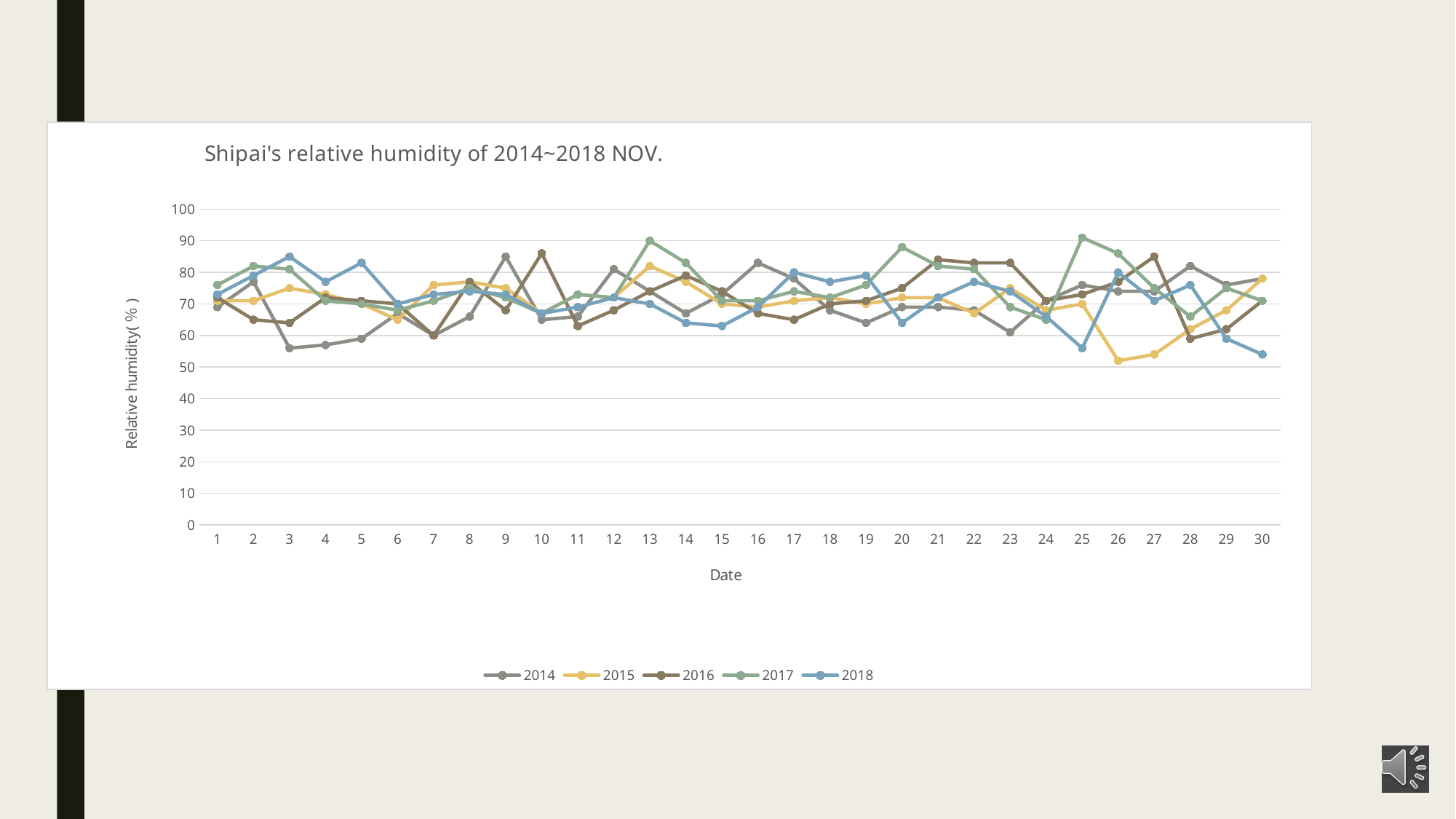
What is the label of the y axis? Relative humidity( % ) On date 26, which is larger, the value for 2015 or the value for 2017? 2017 How many series does the legend list? 5 Is the value for 2014 on date 3 greater or less than 60? less How many dates are plotted along the x axis? 30 Is the value for 2015 on date 26 greater or less than 60? less On date 3, which is larger, the value for 2014 or the value for 2018? 2018 Which series has the lowest value on date 26? 2015 What is the title of the chart? Shipai's relative humidity of 2014~2018 NOV. Is the value for 2018 on date 30 greater or less than 60? less What kind of chart is shown on the slide? line chart